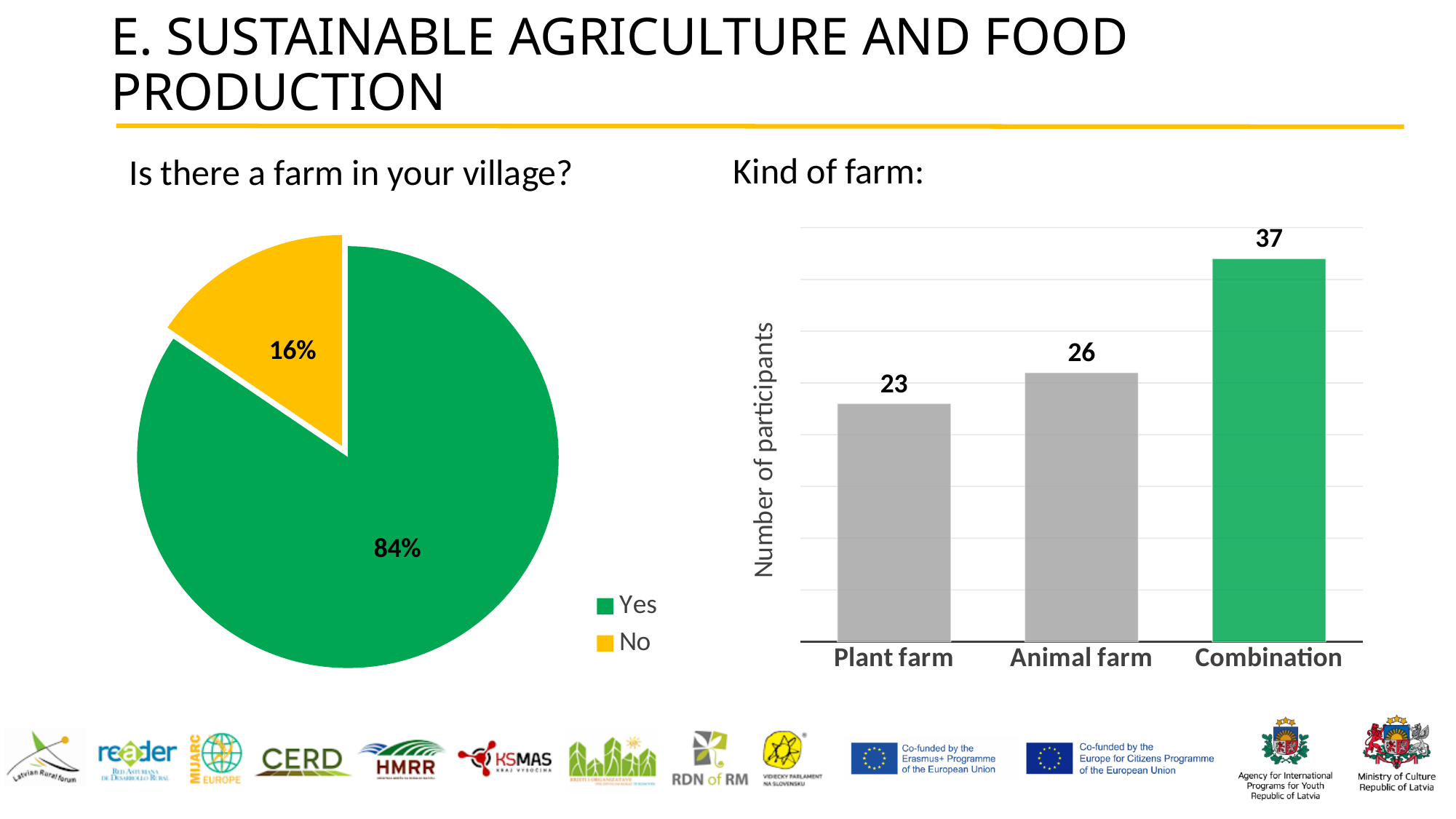
In the 'Is there a farm in your village?' chart, which colour represents No? Yellow In the 'Is there a farm in your village?' chart, what percentage answered Yes? 84% In the 'Kind of farm' chart, what is the difference between Combination and Plant farm? 14 In the 'Kind of farm' chart, how many participants chose Plant farm? 23 In the 'Kind of farm' chart, which category has the highest value? Combination In the 'Kind of farm' chart, which category has the lowest value? Plant farm In the 'Is there a farm in your village?' chart, what percentage answered No? 16% What kind of chart is the 'Kind of farm' chart? Bar chart What kind of chart is the 'Is there a farm in your village?' chart? Pie chart In the 'Kind of farm' chart, how many participants chose Combination? 37 In the 'Is there a farm in your village?' chart, how many entries does the legend list? 2 In the 'Kind of farm' chart, how many participants chose Animal farm? 26